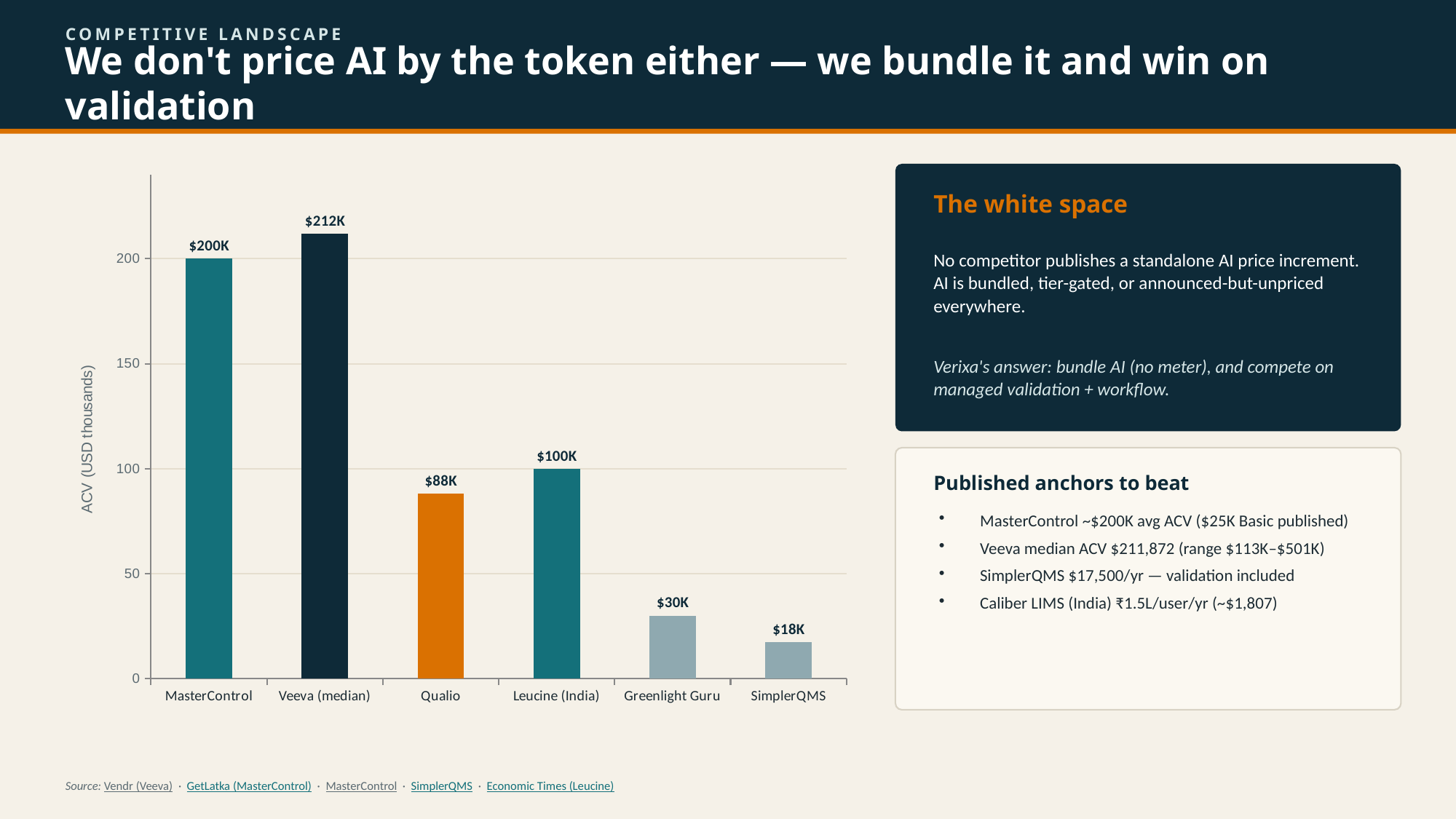
Which category has the lowest ACV in the chart? SimplerQMS Which has a larger ACV, Qualio or Leucine (India)? Leucine (India) What kind of chart is shown on the slide? bar chart What is the label of the y axis of the chart? ACV (USD thousands) How many categories are shown on the x axis of the chart? 6 Is the value for Greenlight Guru greater or less than 50? less What is the ACV value shown for Greenlight Guru? $30K What is the ACV value shown for Leucine (India)? $100K What is the difference between the ACV for Leucine (India) and SimplerQMS? $82K What is the difference between the ACV for Veeva (median) and MasterControl? $12K Which category has the highest ACV in the chart? Veeva (median) What is the ACV value shown for Qualio? $88K